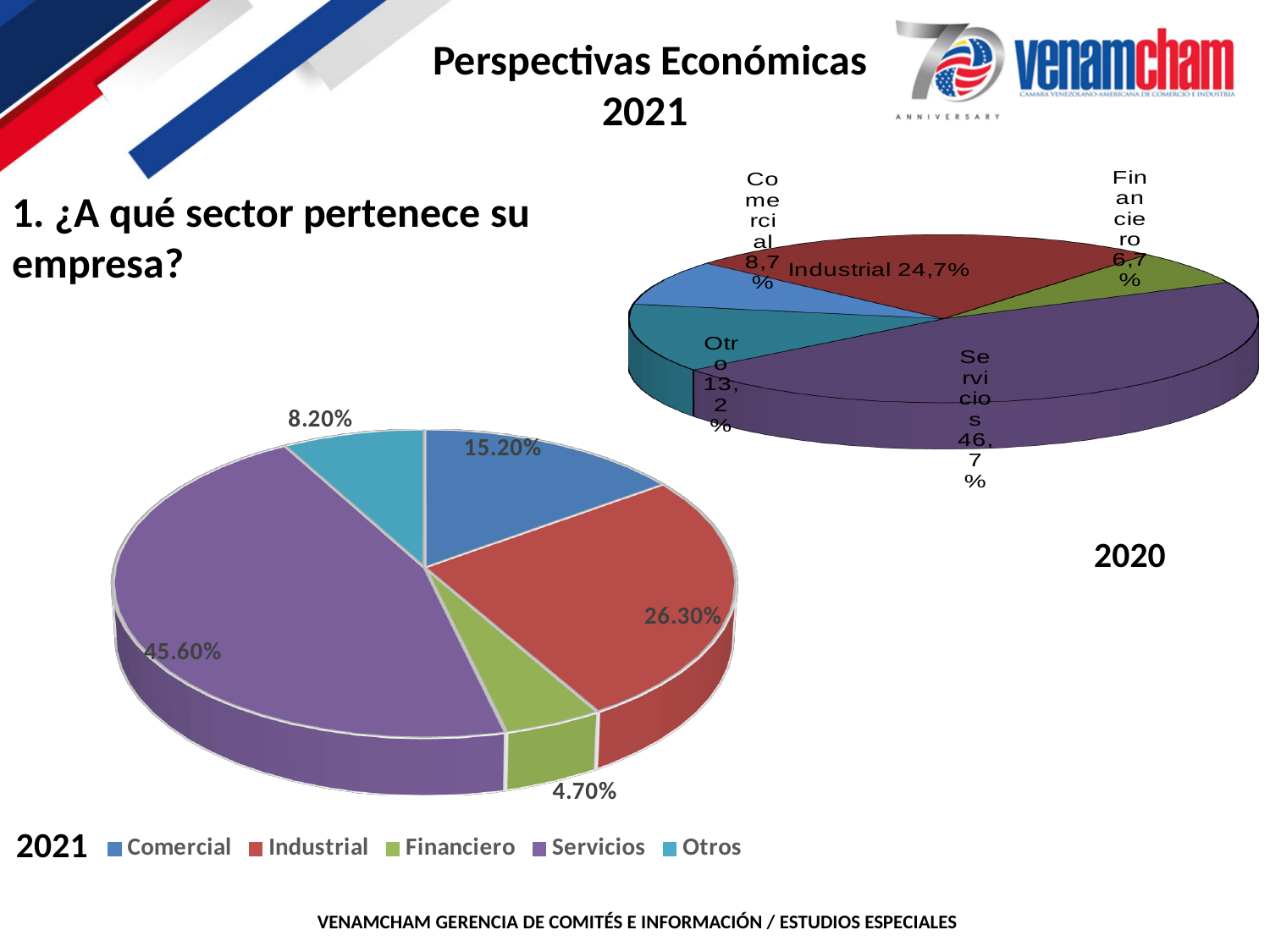
In the 2021 pie chart, what is the difference between the Industrial and Comercial shares? 11.10% In the 2020 pie chart, what share does Industrial have? 24,7% In the 2021 pie chart, what share does Servicios have? 45.60% In the 2020 pie chart, what share does Servicios have? 46,7% In the 2020 pie chart, which sector has the largest share? Servicios What type of chart is used to show the 2021 sector distribution? Pie chart In the 2021 pie chart, which is larger, Otros or Financiero? Otros In the 2021 pie chart, what share does Financiero have? 4.70% How many sectors does the legend of the 2021 pie chart list? 5 In the 2021 pie chart, what share does Comercial have? 15.20% In the 2021 pie chart, which sector has the smallest share? Financiero In the 2021 pie chart, which sector has the largest share? Servicios